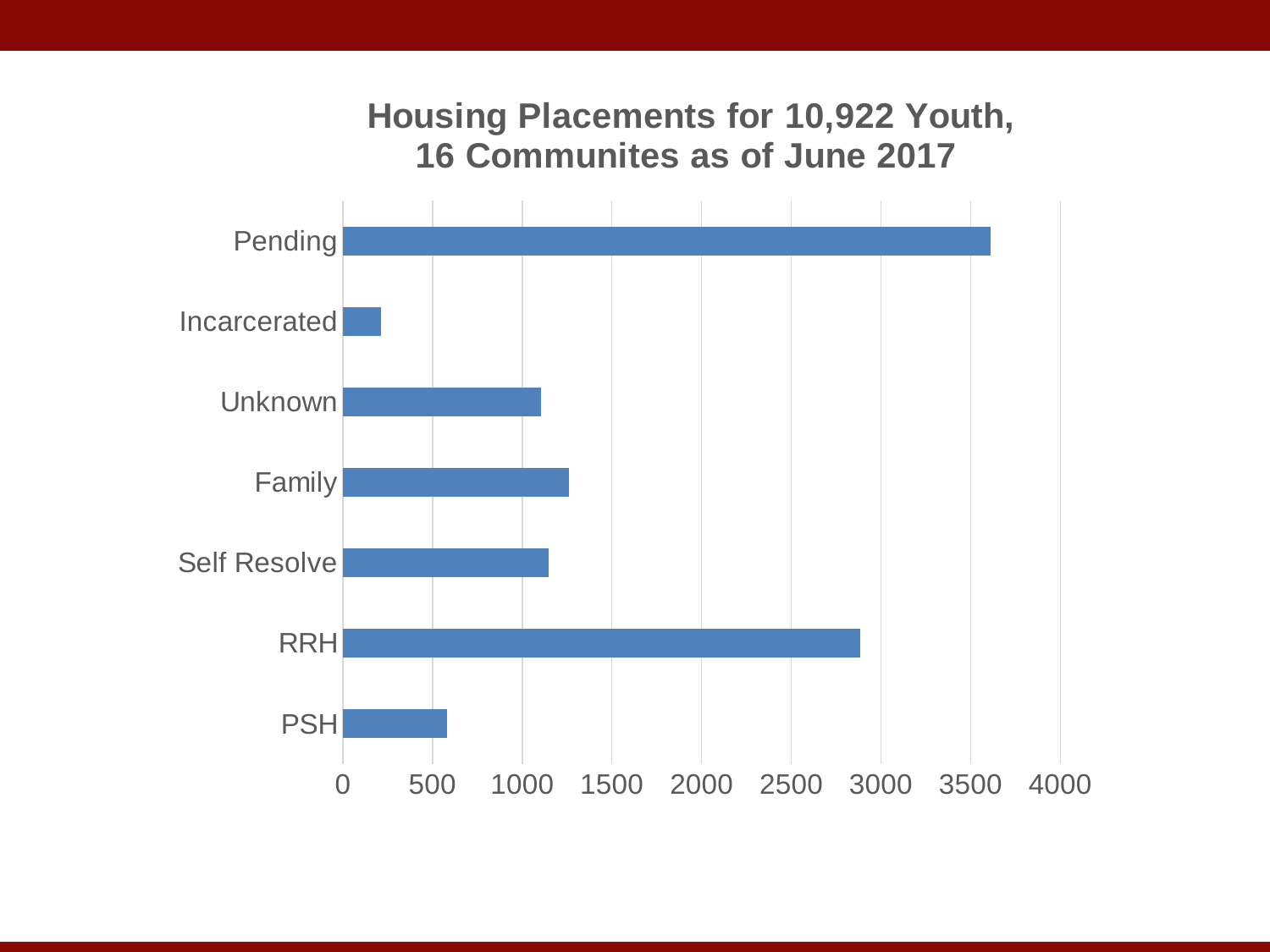
Is the value for Pending greater or less than 3500? greater Is the value for PSH greater or less than 500? greater Which is larger, the value for Pending or the value for RRH? Pending Which category has the highest value? Pending Is the value for RRH greater or less than 3000? less What kind of chart is shown on the slide? bar chart What is the title of the chart? Housing Placements for 10,922 Youth, 16 Communites as of June 2017 How many categories are plotted on the chart? 7 Which is larger, the value for RRH or the value for PSH? RRH Which category has the lowest value? Incarcerated